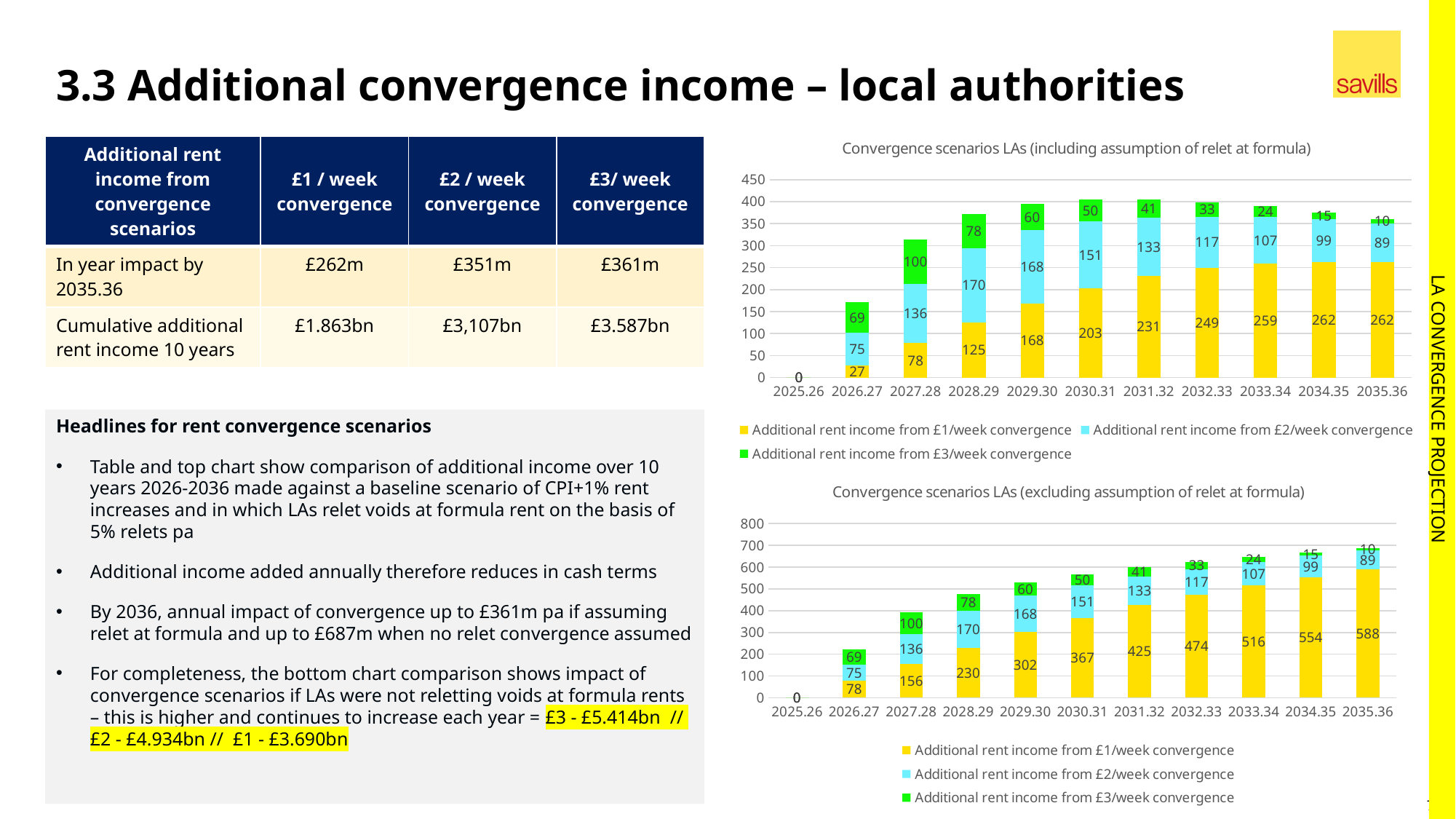
In the bottom chart (excluding assumption of relet at formula), is the £1/week convergence value for 2031.32 larger or smaller than the £2/week convergence value for the same year? larger In the top chart (including assumption of relet at formula), what is the value of the £3/week convergence series for 2027.28? 100 In the top chart (including assumption of relet at formula), what is the value of the £1/week convergence series for 2030.31? 203 How many series does the legend of the top chart list? 3 In the bottom chart (excluding assumption of relet at formula), what is the total of the stacked bar for 2035.36? 687 What kind of chart is the bottom chart (excluding assumption of relet at formula)? Stacked bar chart In the bottom chart (excluding assumption of relet at formula), what is the value of the £2/week convergence series for 2029.30? 168 In the bottom chart (excluding assumption of relet at formula), what is the value of the £1/week convergence series for 2035.36? 588 In the top chart (including assumption of relet at formula), what is the total of the stacked bar for 2035.36? 361 In the top chart (including assumption of relet at formula), what is the difference between the £1/week convergence values for 2032.33 and 2026.27? 222 In the bottom chart (excluding assumption of relet at formula), does the £1/week convergence series rise or fall from 2026.27 to 2035.36? Rise In the top chart (including assumption of relet at formula), which year has the highest value for the £3/week convergence series? 2027.28